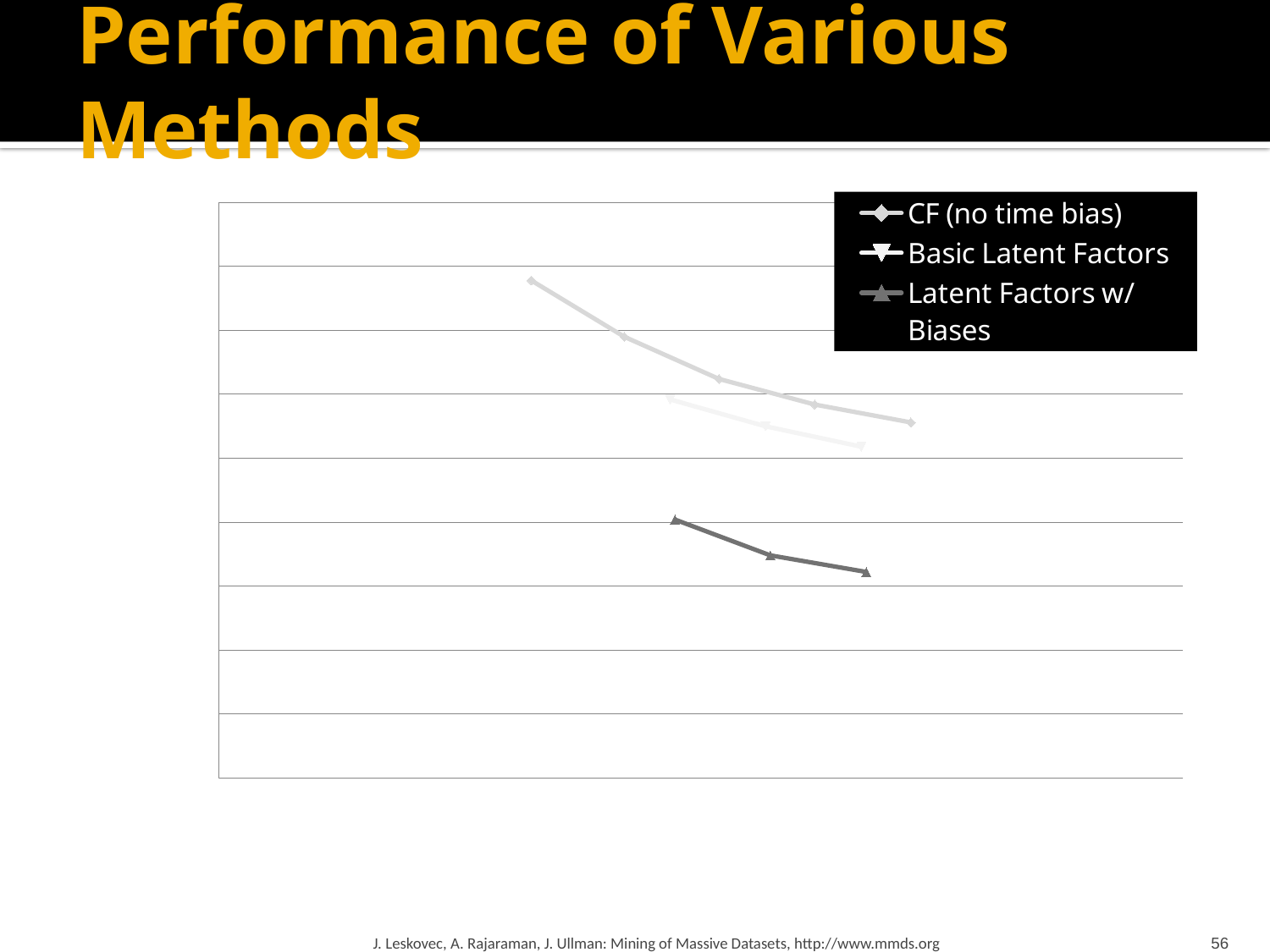
Which series is plotted lowest on the chart? Latent Factors w/ Biases Do the values of the CF (no time bias) series rise or fall along the x axis? fall How many data points are plotted for the Latent Factors w/ Biases series? 3 How many series does the legend list? 3 What is the first series listed in the legend? CF (no time bias) Do the values of the Latent Factors w/ Biases series rise or fall along the x axis? fall What kind of chart is shown on the slide? line chart Which series is plotted highest on the chart? CF (no time bias) Which series has higher values, CF (no time bias) or Latent Factors w/ Biases? CF (no time bias) Which series has higher values, Basic Latent Factors or Latent Factors w/ Biases? Basic Latent Factors What is the title of the slide containing the chart? Performance of Various Methods